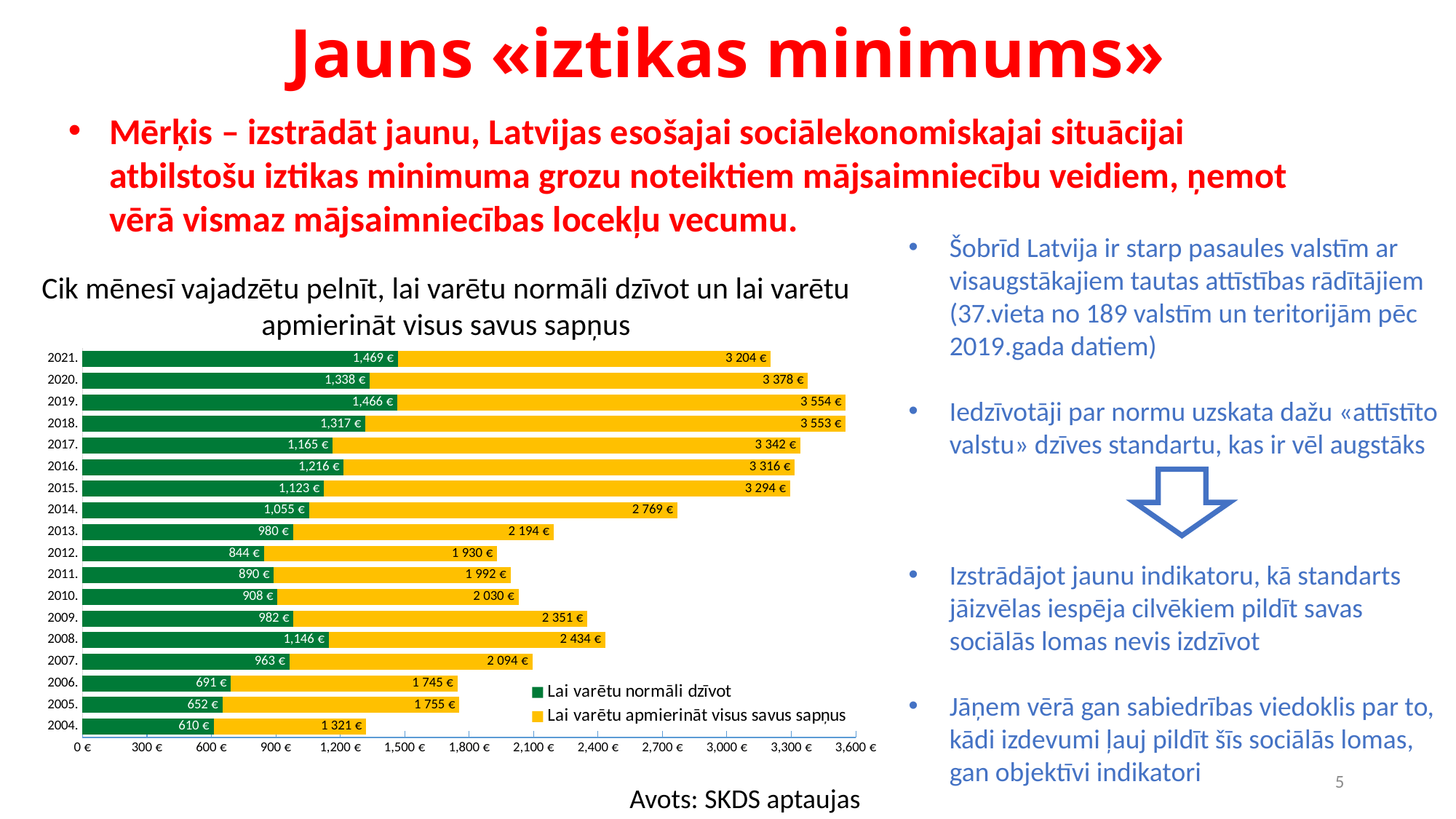
Which year has the lowest value in the series "Lai varētu apmierināt visus savus sapņus"? 2004 What kind of chart is shown on the slide? bar chart How many series does the legend list? 2 How many years are shown on the chart? 18 What is the value for 2004 in the series "Lai varētu normāli dzīvot"? 610 € Is the "Lai varētu apmierināt visus savus sapņus" value for 2020 greater or less than 3,300 €? greater Which year has the lowest value in the series "Lai varētu normāli dzīvot"? 2004 What is the value for 2019 in the series "Lai varētu apmierināt visus savus sapņus"? 3 554 € What is the value for 2021 in the series "Lai varētu normāli dzīvot"? 1,469 € What is the difference between the two series' values for 2004? 711 € What is the value for 2014 in the series "Lai varētu apmierināt visus savus sapņus"? 2 769 € Which is larger: the "Lai varētu normāli dzīvot" value for 2008 or for 2009? 2008